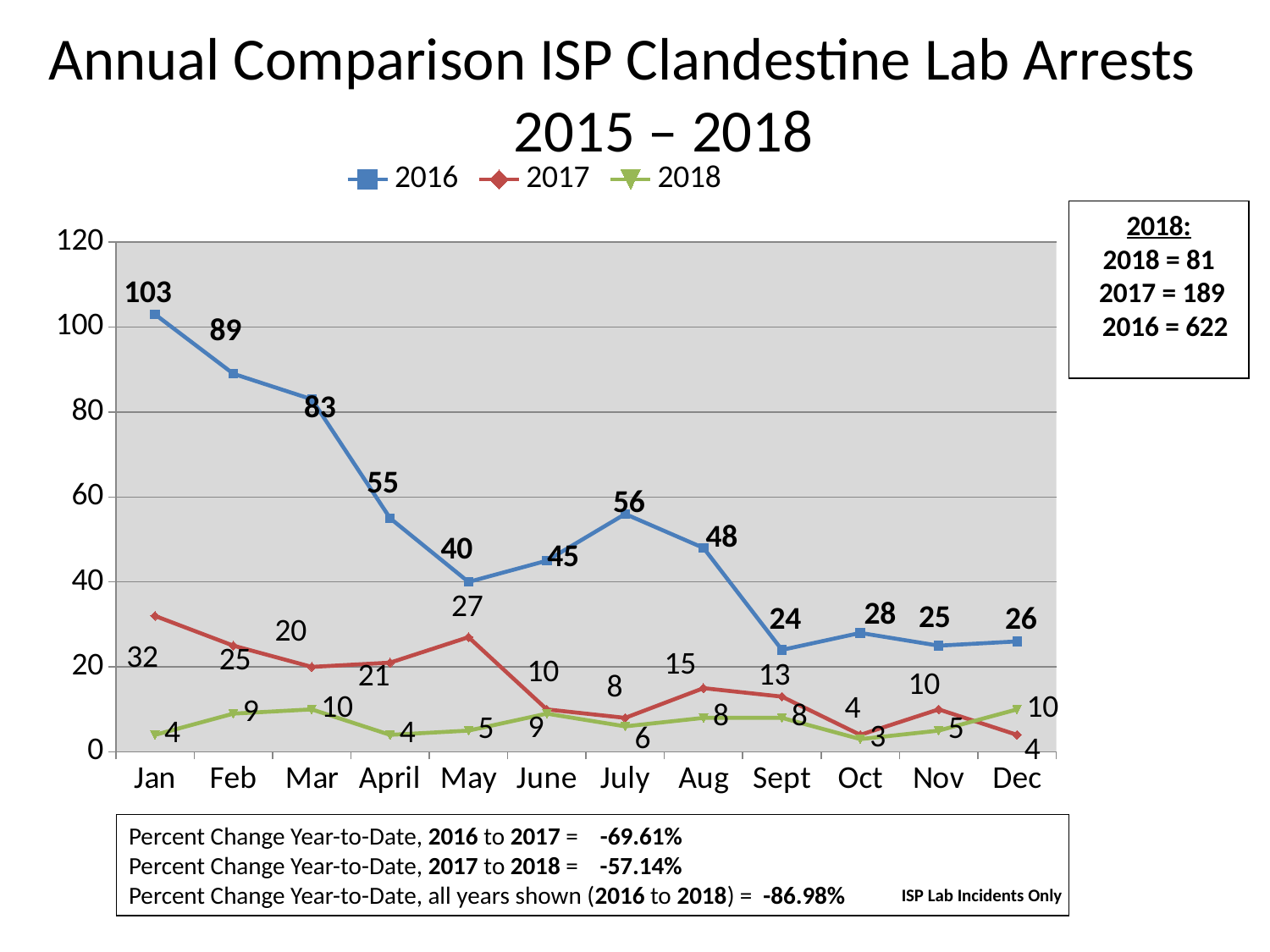
Does the 2016 series generally rise or fall from Jan to Dec? fall In which month is the 2016 series highest? Jan What is the 2016 value for Jan? 103 What is the 2018 value for Dec? 10 How many months are shown on the x axis? 12 Which colour is used for the 2017 series? red What kind of chart is this? line chart In which month is the 2016 series lowest? Sept How many series does the legend list? 3 What is the difference between the 2016 and 2017 values for Jan? 71 Which is larger in Dec, the 2017 value or the 2018 value? 2018 What is the 2017 value for May? 27